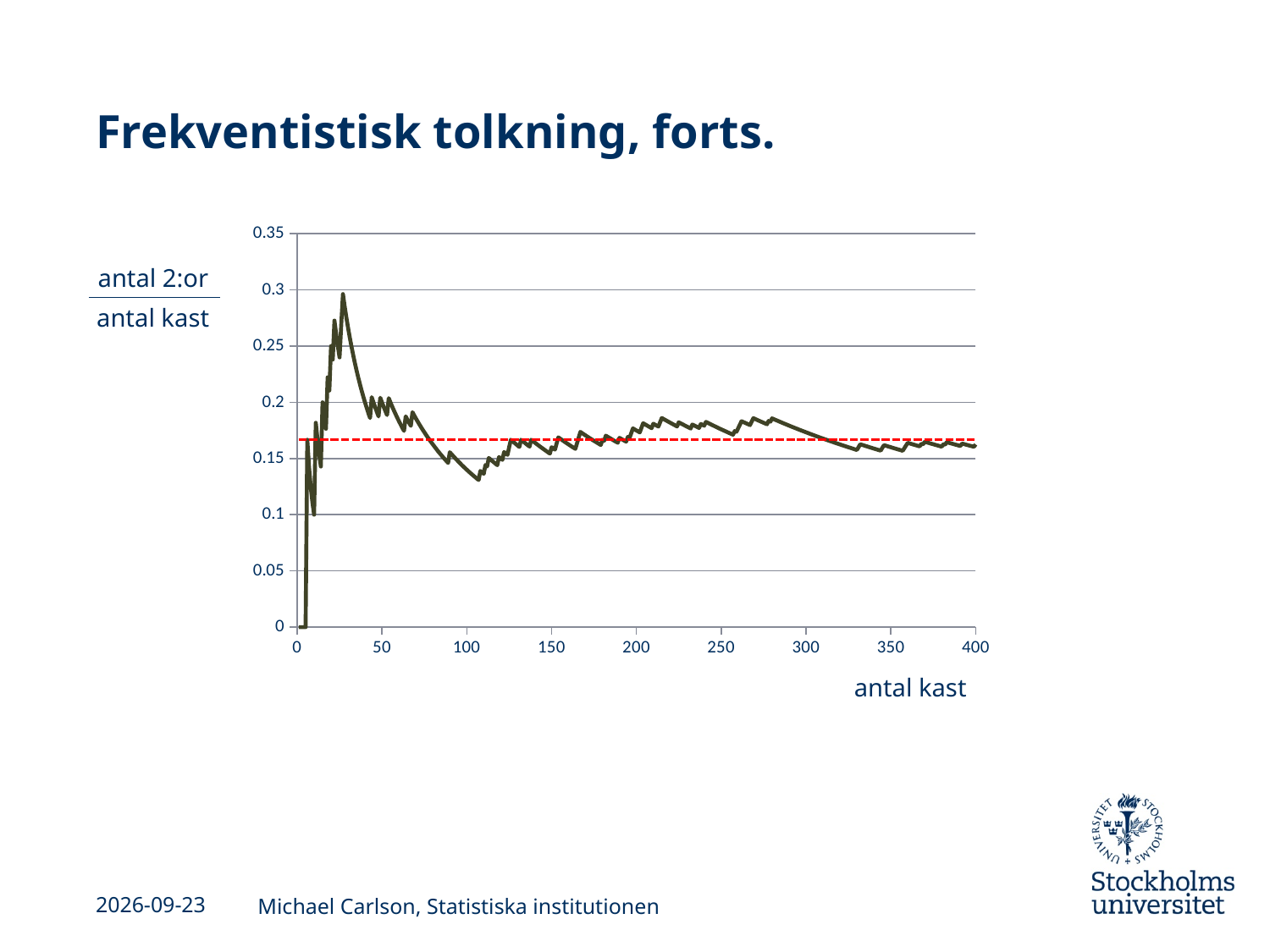
Is the red dashed reference line above or below 0.2 on the y axis? below What kind of chart is shown on the slide? line chart Between about 30 and 100 throws, does the solid line generally rise or fall? fall What is the spacing between consecutive tick marks on the x axis? 50 What is the largest value shown on the x axis of the chart? 400 Which is larger: the value of the solid line at 25 throws or at 400 throws? at 25 throws Is the peak value of the solid line, reached near 25 throws, greater or less than 0.25? greater Is the value of the solid line at 200 throws greater or less than 0.15? greater What is the highest value shown on the y axis of the chart? 0.35 What is the label on the x axis of the chart? antal kast